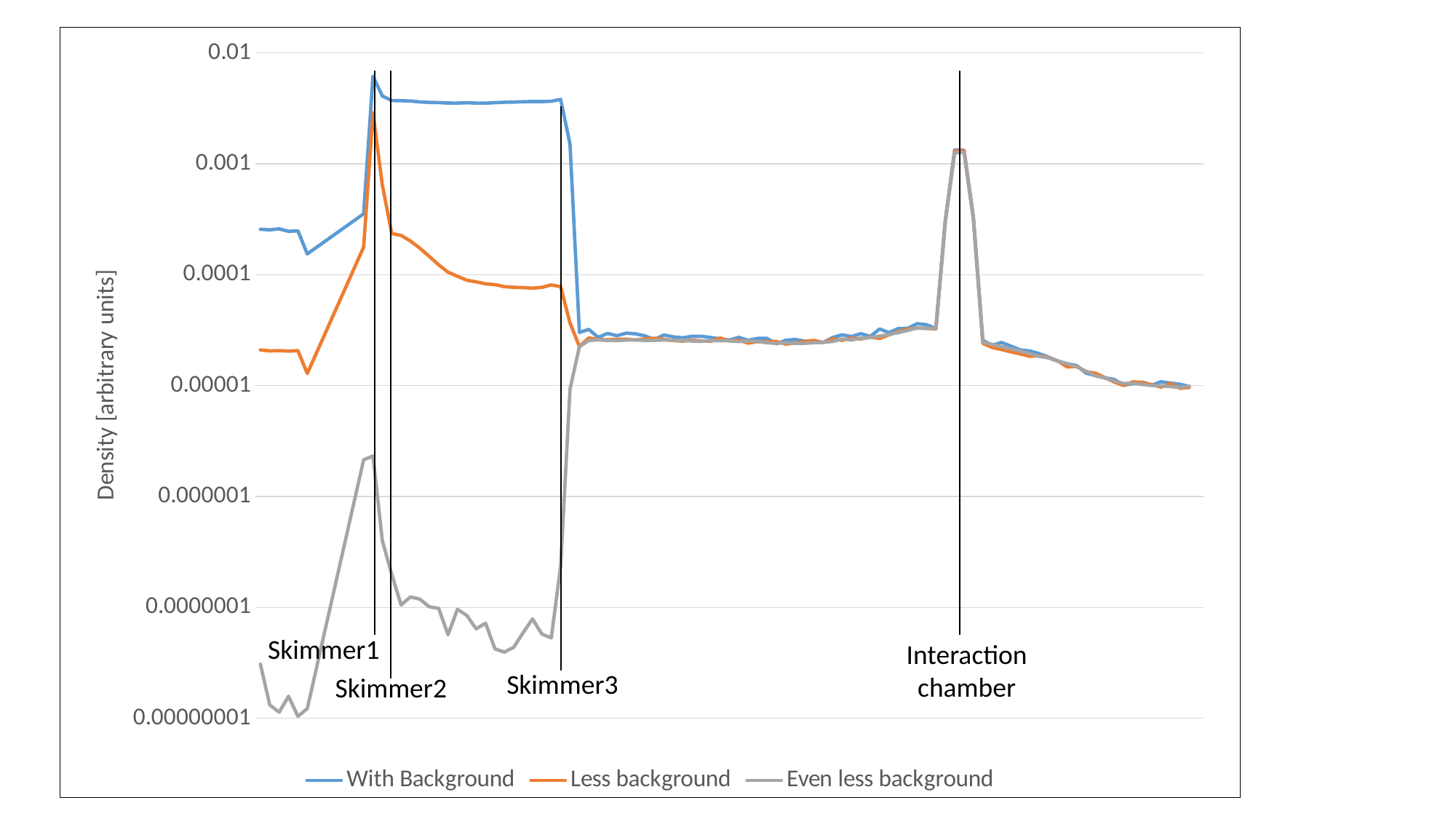
Which series is drawn in orange according to the legend? Less background Between Skimmer2 and Skimmer3, is the value of the Even less background series greater or less than 0.000001? less Between Skimmer2 and Skimmer3, is the value of the With Background series greater or less than 0.001? greater What is the title of the vertical axis? Density [arbitrary units] How many series does the legend list? 3 What kind of chart is shown on the slide? line chart Between Skimmer2 and Skimmer3, which series has the highest density? With Background Between Skimmer2 and Skimmer3, is the value of the Less background series greater or less than 0.001? less Between Skimmer2 and Skimmer3, which is larger: the With Background series or the Less background series? With Background After the Interaction chamber peak, do the density values rise or fall toward the right end of the chart? fall Between Skimmer2 and Skimmer3, which series has the lowest density? Even less background